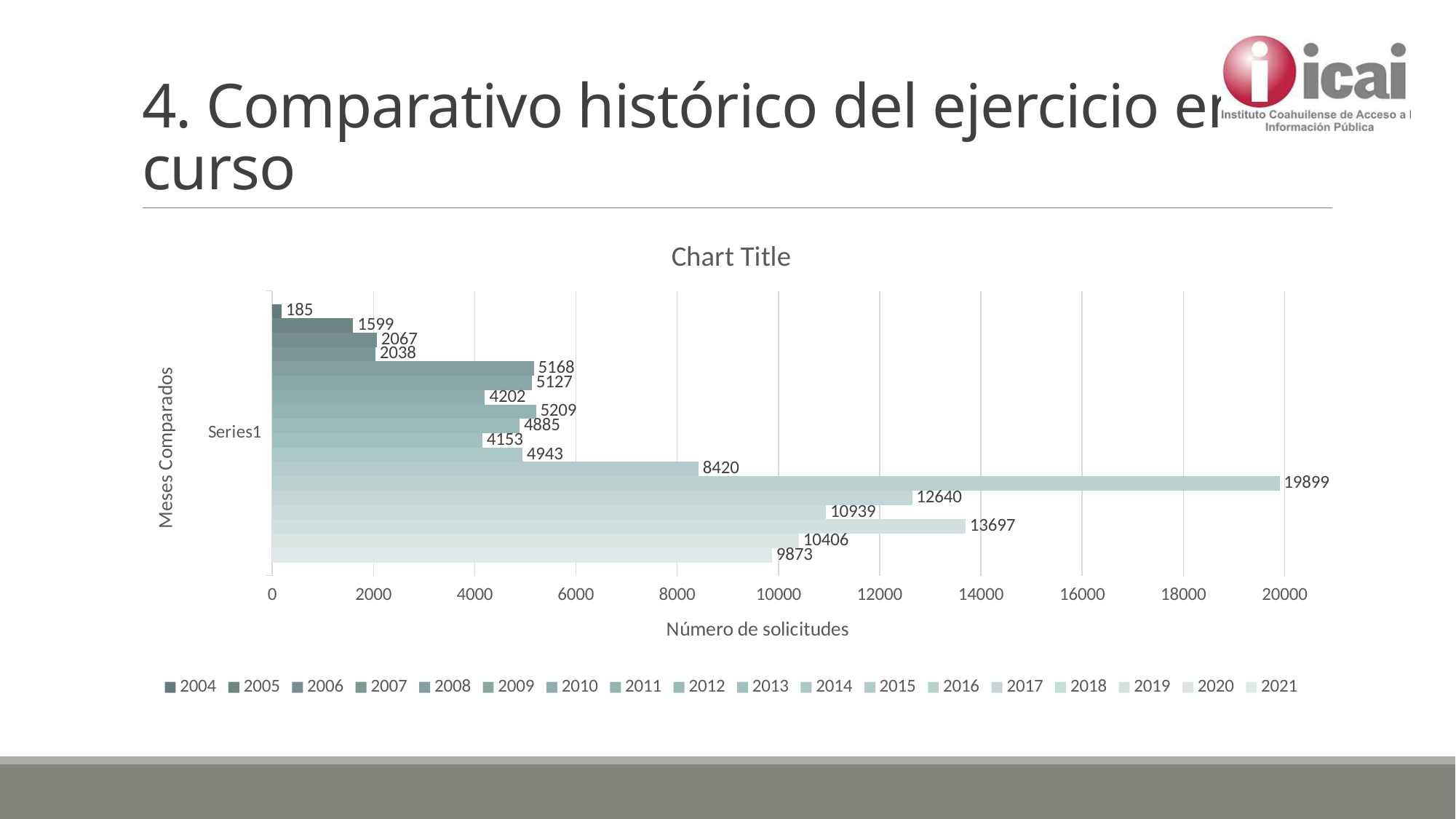
What is the value of the shortest bar in the chart? 185 What is the label on the y axis of the chart? Meses Comparados What is the value of the longest bar in the chart? 19899 What is the difference between the longest bar (19899) and the bar labelled 12640? 7259 What is the label on the x axis of the chart? Número de solicitudes Is the value for 2017 (the bar labelled 12640) greater or less than 12000? greater What is the value for 2021, the bottom bar in the chart? 9873 What kind of chart is shown on the slide? bar chart Which year in the legend corresponds to the longest bar (19899)? 2016 What is the value for 2015 (the bar labelled just above the longest bar)? 8420 How many series does the legend list? 18 Which is larger, the bar labelled 13697 or the bar labelled 10939? 13697